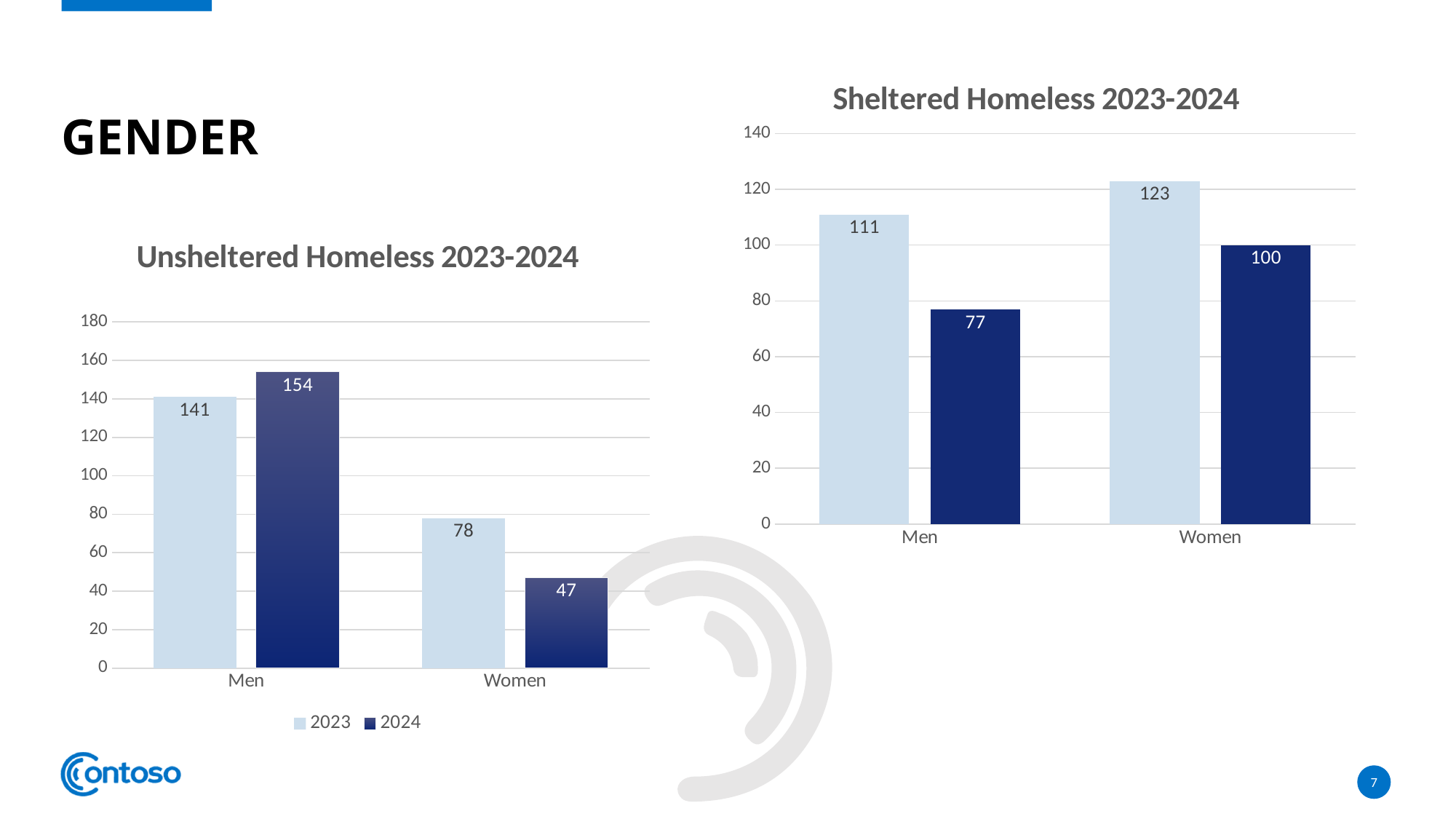
In the Sheltered Homeless 2023-2024 chart, what is the value for Women in 2024? 100 What kind of chart is the Sheltered Homeless 2023-2024 chart? Bar chart In the Unsheltered Homeless 2023-2024 chart, what is the difference between the Men values for 2024 and 2023? 13 In the Unsheltered Homeless 2023-2024 chart, which bar has the lowest value? Women 2024 In the Unsheltered Homeless 2023-2024 chart, what is the value for Men in 2024? 154 How many series does the legend of the Unsheltered Homeless 2023-2024 chart list? 2 In the Sheltered Homeless 2023-2024 chart, what is the difference between the Men values for 2023 and 2024? 34 In the Sheltered Homeless 2023-2024 chart, which is larger: Women in 2023 or Women in 2024? Women in 2023 In the Sheltered Homeless 2023-2024 chart, which bar has the highest value? Women 2023 How many categories are shown on the x axis of the Unsheltered Homeless 2023-2024 chart? 2 In the Sheltered Homeless 2023-2024 chart, what is the value for Men in 2023? 111 In the Unsheltered Homeless 2023-2024 chart, what is the value for Women in 2023? 78